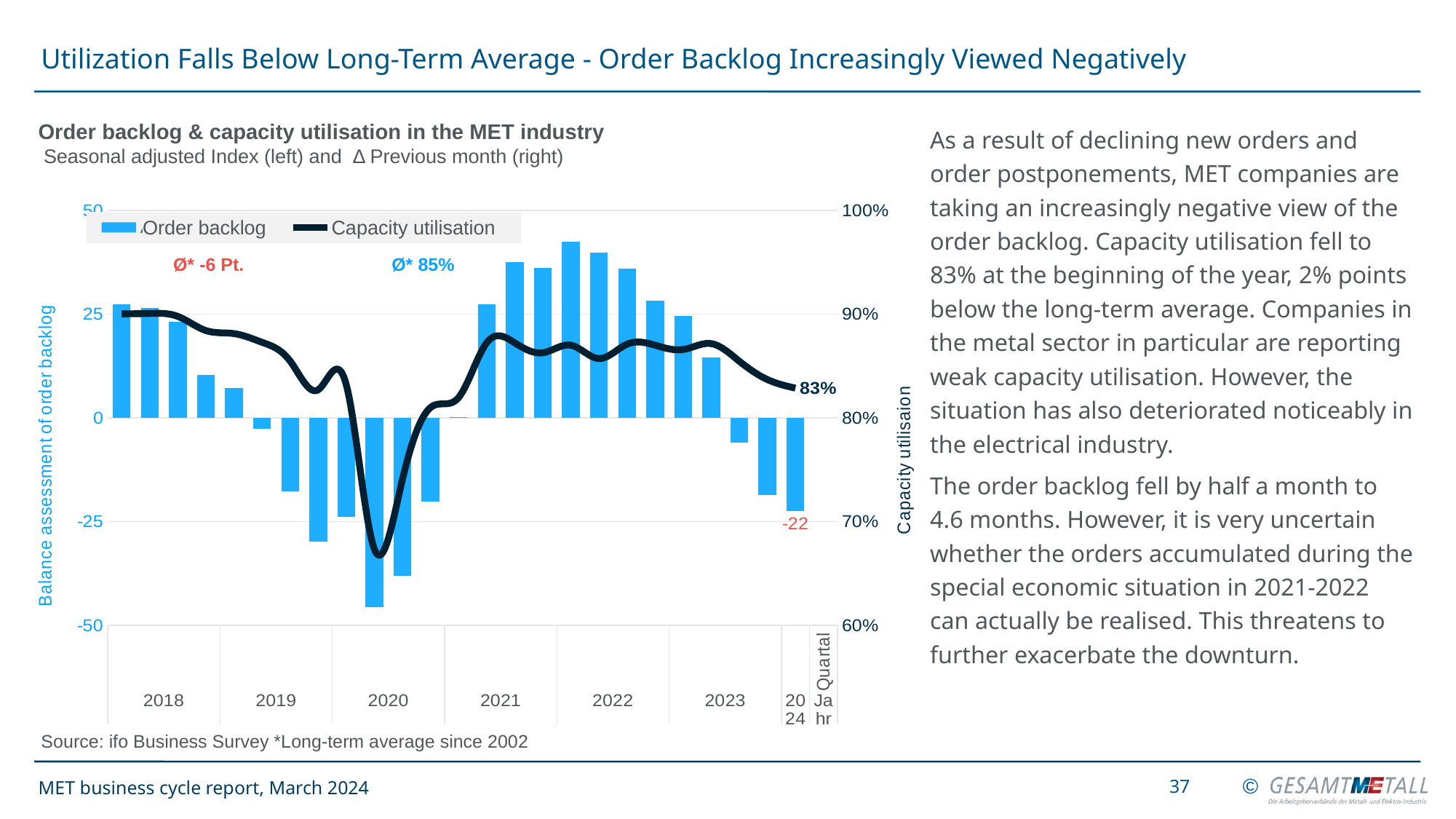
In which year does the order backlog reach its lowest bar? 2020 How many series does the legend list? 2 By how many percentage points is the latest capacity utilisation (83%) below its long-term average (85%)? 2 percentage points What kind of chart is used to show the order backlog? Bar chart (combined with a line for capacity utilisation) What long-term average is shown for capacity utilisation? 85% What long-term average is shown for the order backlog? -6 Pt. What is the range of the right-hand (capacity utilisation) axis? 60% to 100% What is the labelled value of the order backlog for the latest bar (2024)? -22 In which year does the order backlog reach its highest bar? 2022 Does capacity utilisation rise or fall from 2023 into 2024? fall Is the lowest order backlog bar in 2020 greater or less than -25? less What is the labelled capacity utilisation value at the end of the line (2024)? 83%